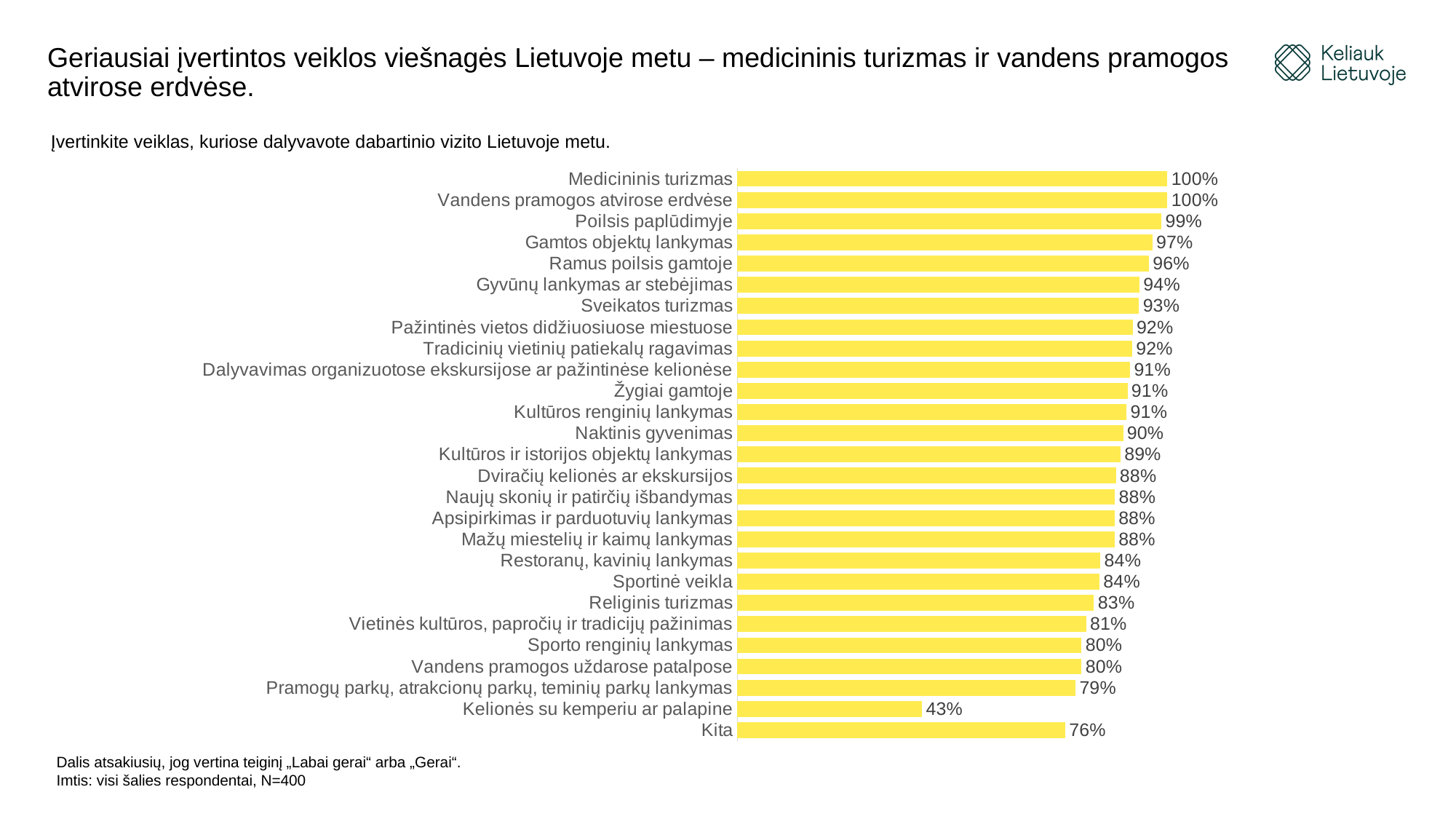
What kind of chart is shown on the slide? Bar chart What colour are the bars in the chart? Yellow What is the value for Religinis turizmas? 83% What is the difference between the values for Gamtos objektų lankymas and Sporto renginių lankymas? 17% What is the difference between the values for Medicininis turizmas and Kelionės su kemperiu ar palapine? 57% How many categories are shown in the chart? 27 What is the value for Poilsis paplūdimyje? 99% What is the value for Kita? 76% What is the value for Kelionės su kemperiu ar palapine? 43% Which is larger, the value for Kita or the value for Pramogų parkų, atrakcionų parkų, teminių parkų lankymas? Pramogų parkų, atrakcionų parkų, teminių parkų lankymas Which category has the lowest value? Kelionės su kemperiu ar palapine Which is larger, the value for Naktinis gyvenimas or the value for Sportinė veikla? Naktinis gyvenimas